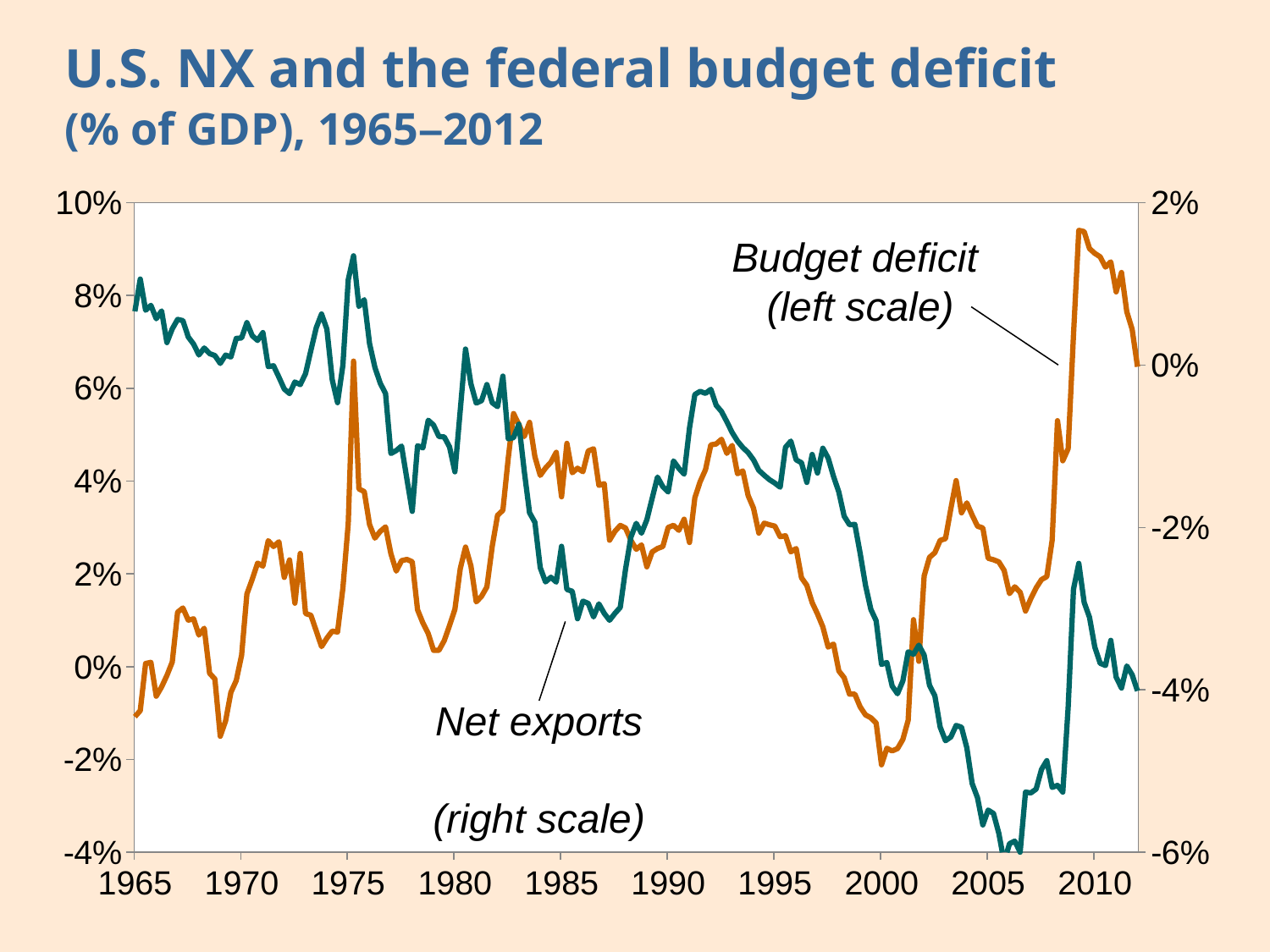
In which year does the budget deficit line reach its highest point? 2009 Is the net exports value in 1965 greater or less than 0% on the right scale? greater What period does the chart's title say the data covers? 1965–2012 Is the budget deficit larger around 2009 or around 2000? 2009 Is the net exports value around 2006 greater or less than -4% on the right scale? less Which scale does the Net exports series use? Right scale Around which year does the net exports line reach its lowest point? 2006 Does the net exports line overall rise or fall from 1965 to 2012? Fall How many series are plotted on the chart? 2 Is the budget deficit value around 2000 greater or less than 0% on the left scale? less What kind of chart is shown on the slide? Line chart